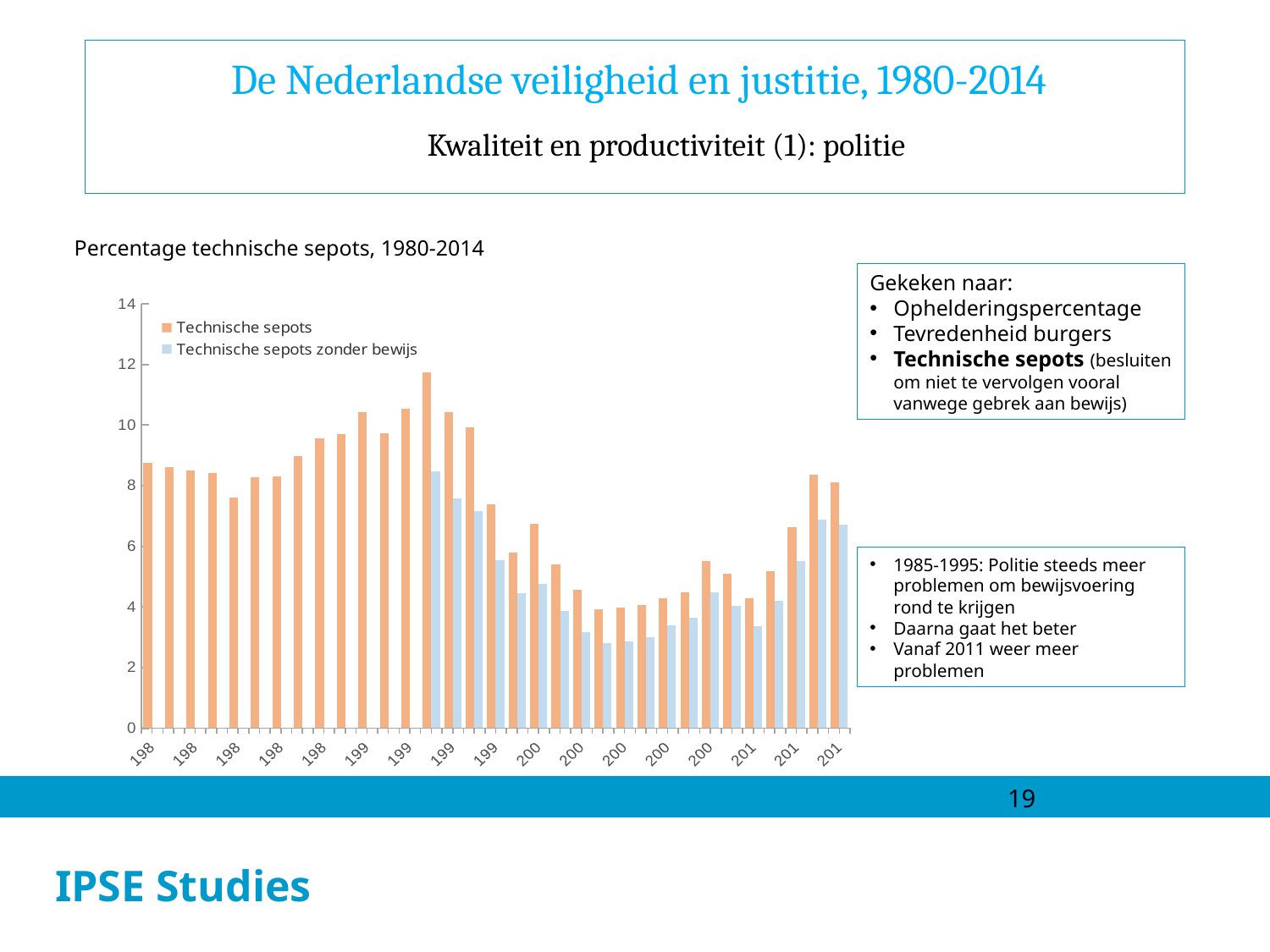
How many series does the chart's legend list? 2 Is the highest value for Technische sepots greater or less than 10? greater From the peak in the mid-1990s to the mid-2000s, do the values for Technische sepots rise or fall? fall Is the first (leftmost) bar for Technische sepots greater or less than 8? greater In the rightmost year, which series has the higher value: Technische sepots or Technische sepots zonder bewijs? Technische sepots Which series has the higher values throughout the chart: Technische sepots or Technische sepots zonder bewijs? Technische sepots Over the last few years on the right of the chart, do the values for Technische sepots zonder bewijs rise or fall? rise Which series is shown in orange in the chart? Technische sepots What is the title of the chart? Percentage technische sepots, 1980-2014 Is the lowest value for Technische sepots zonder bewijs greater or less than 4? less What kind of chart is shown on the slide? bar chart